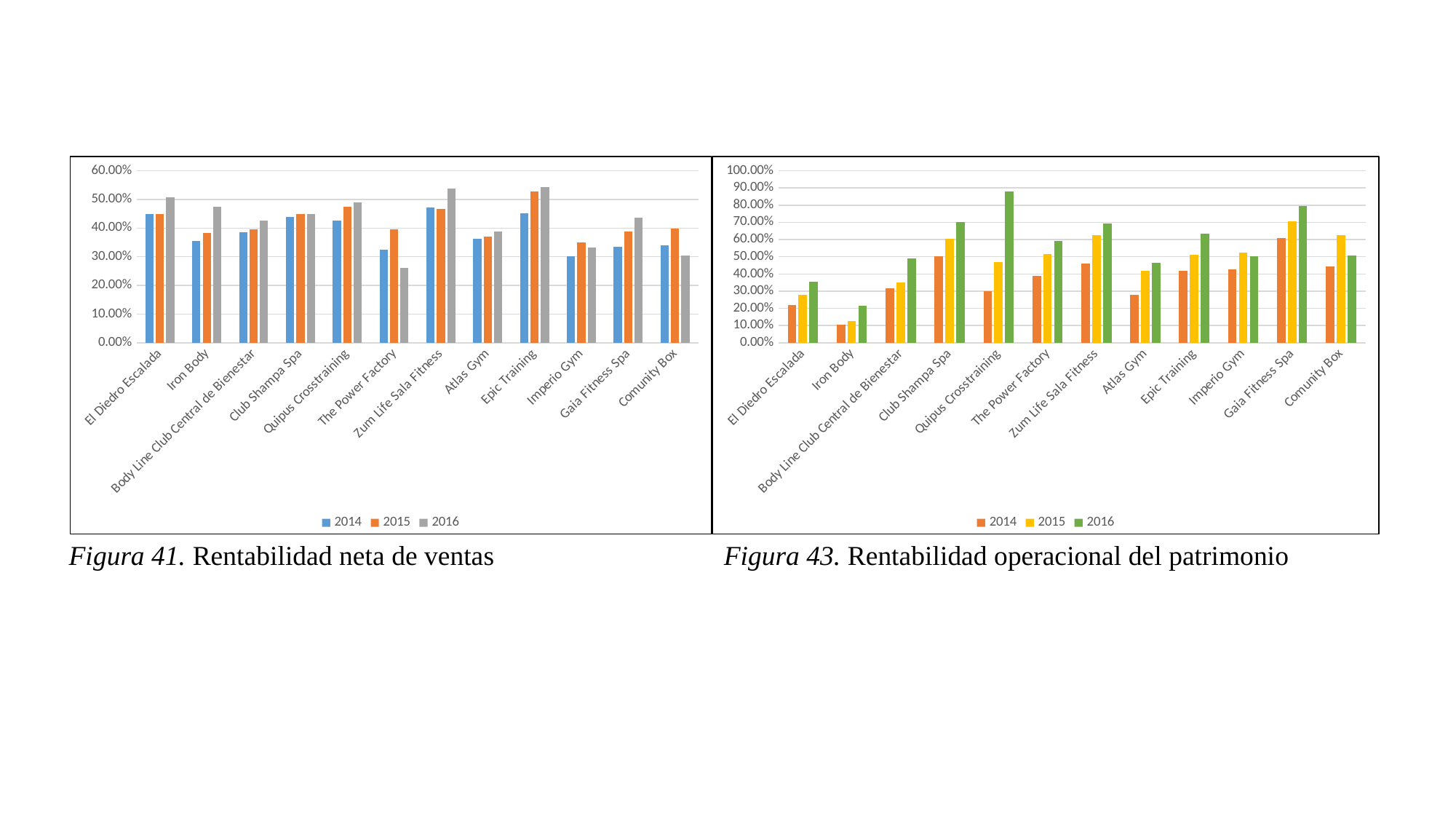
In Figura 43 (Rentabilidad operacional del patrimonio), is the 2015 value for Iron Body greater or less than 20.00%? less In Figura 43 (Rentabilidad operacional del patrimonio), which is larger: the 2016 value for Club Shampa Spa or the 2016 value for Atlas Gym? Club Shampa Spa What kind of chart is Figura 41 (Rentabilidad neta de ventas)? bar chart What colour represents the 2016 series in Figura 43 (Rentabilidad operacional del patrimonio)? green In Figura 41 (Rentabilidad neta de ventas), which is larger: the 2016 value for Epic Training or the 2016 value for Imperio Gym? Epic Training In Figura 43 (Rentabilidad operacional del patrimonio), which business has the lowest 2014 value? Iron Body In Figura 43 (Rentabilidad operacional del patrimonio), which business has the highest 2016 value? Quipus Crosstraining How many series does the legend of Figura 43 (Rentabilidad operacional del patrimonio) list? 3 How many categories (businesses) are shown on the x axis of Figura 41 (Rentabilidad neta de ventas)? 12 In Figura 41 (Rentabilidad neta de ventas), is the 2016 value for The Power Factory greater or less than 30.00%? less In Figura 41 (Rentabilidad neta de ventas), which business has the lowest 2016 value? The Power Factory In Figura 43 (Rentabilidad operacional del patrimonio), is the 2016 value for Quipus Crosstraining greater or less than 80.00%? greater